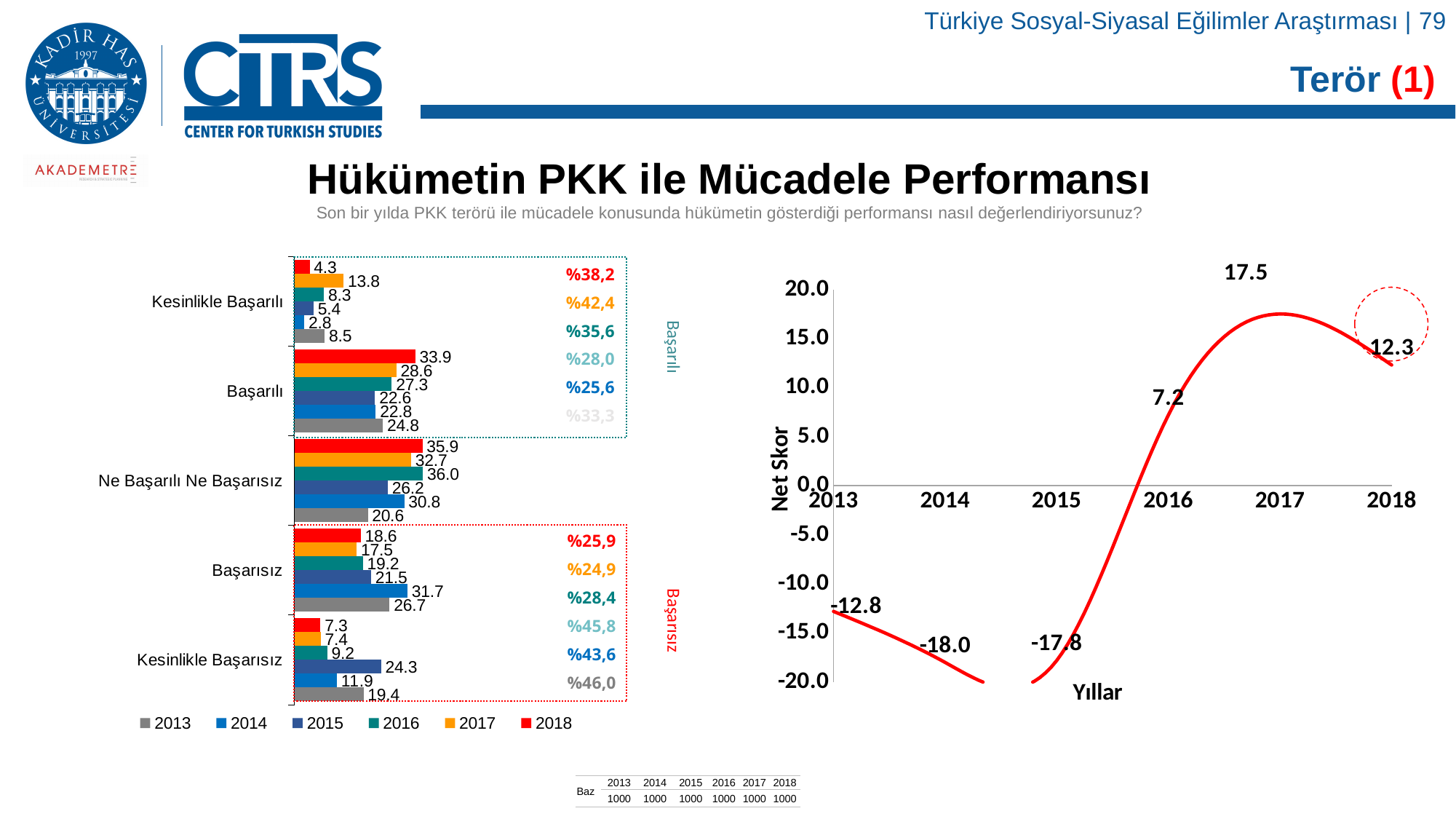
In the bar chart on the left, what is the value for 2015 in the Kesinlikle Başarısız category? 24.3 In the bar chart on the left, which year has the highest value in the Başarısız category? 2014 In the bar chart on the left, what is the difference between the 2018 and 2013 values in the Ne Başarılı Ne Başarısız category? 15.3 In the bar chart on the left, which is larger in the Başarısız category: the 2013 value or the 2018 value? 2013 How many categories are shown on the bar chart on the left? 5 How many series does the legend of the bar chart on the left list? 6 In the bar chart on the left, what is the value for 2014 in the Kesinlikle Başarılı category? 2.8 In the bar chart on the left, which year has the lowest value in the Kesinlikle Başarılı category? 2014 In the Net Skor line chart on the right, what is the value for 2017? 17.5 What kind of chart is the Net Skor chart on the right? line chart In the Net Skor line chart on the right, which year has the lowest value? 2014 In the bar chart on the left, what is the value for 2018 in the Başarılı category? 33.9